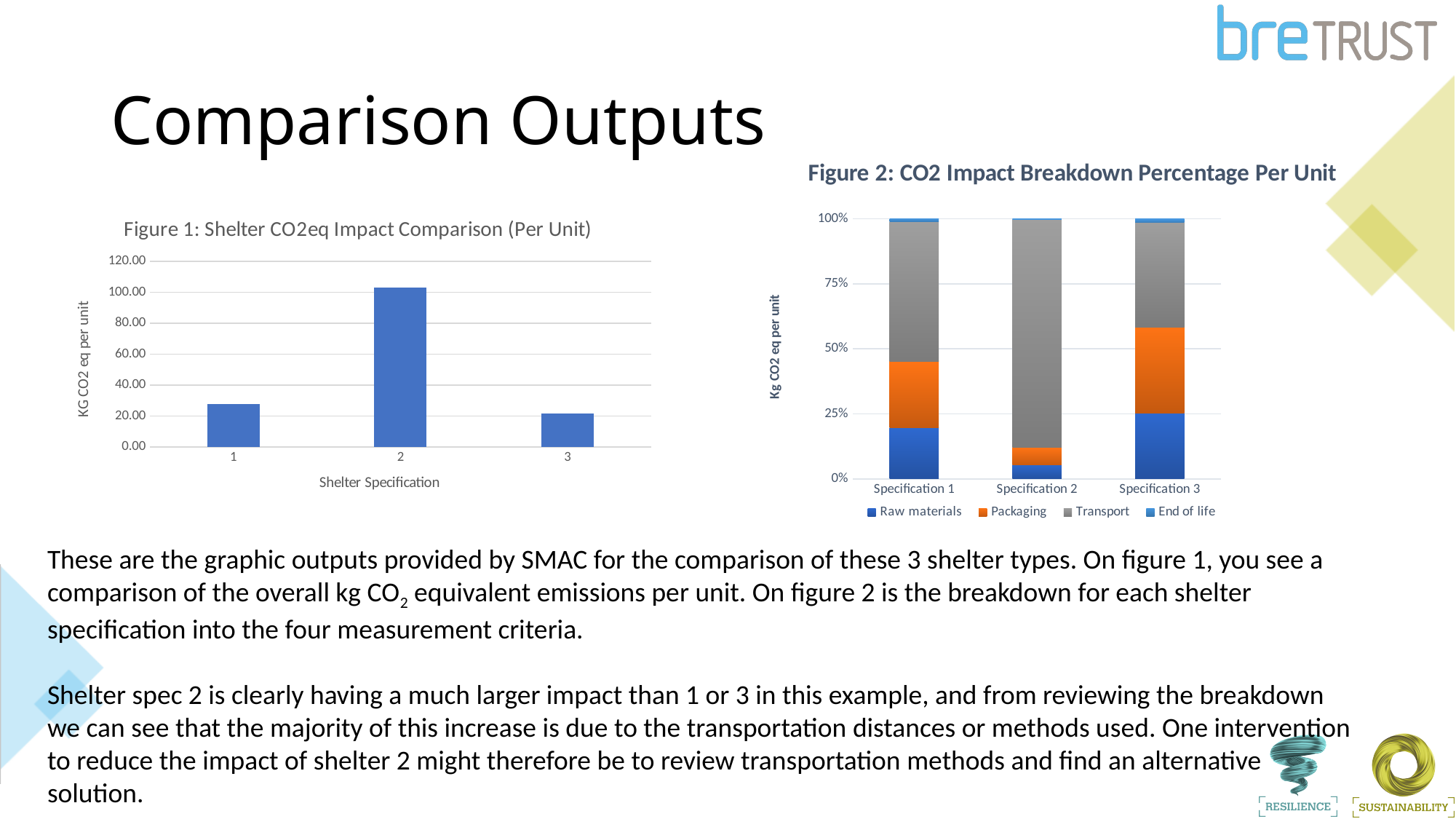
In Figure 2: CO2 Impact Breakdown Percentage Per Unit, how many series does the legend list? 4 In Figure 1: Shelter CO2eq Impact Comparison (Per Unit), is the value for shelter specification 2 greater or less than 100.00? greater In Figure 1: Shelter CO2eq Impact Comparison (Per Unit), what kind of chart is shown? Bar chart In Figure 1: Shelter CO2eq Impact Comparison (Per Unit), which is larger, the value for specification 1 or specification 3? Specification 1 In Figure 1: Shelter CO2eq Impact Comparison (Per Unit), how many shelter specifications are plotted? 3 What is the y-axis label of Figure 1: Shelter CO2eq Impact Comparison (Per Unit)? KG CO2 eq per unit In Figure 2: CO2 Impact Breakdown Percentage Per Unit, which series is shown in orange? Packaging In Figure 1: Shelter CO2eq Impact Comparison (Per Unit), is the value for shelter specification 1 greater or less than 40.00? less In Figure 2: CO2 Impact Breakdown Percentage Per Unit, which specification has the largest Transport share? Specification 2 In Figure 1: Shelter CO2eq Impact Comparison (Per Unit), which shelter specification has the highest CO2 eq per unit? 2 In Figure 1: Shelter CO2eq Impact Comparison (Per Unit), which shelter specification has the lowest CO2 eq per unit? 3